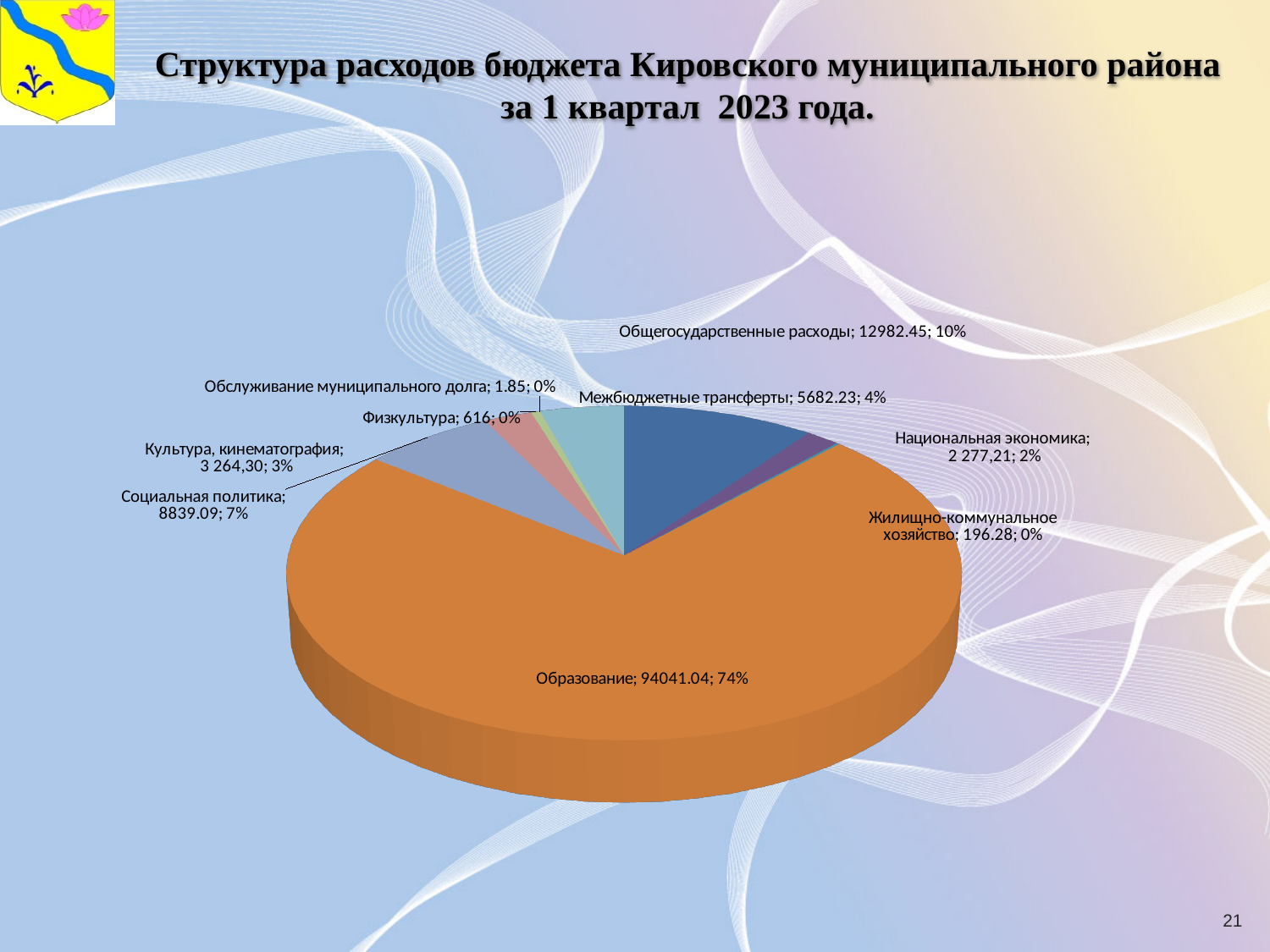
What kind of chart is shown on the slide? Pie chart What share of the pie does Межбюджетные трансферты represent? 4% How many categories (slices) does the pie chart show? 9 What is the difference between the values for Общегосударственные расходы and Межбюджетные трансферты? 7300.22 What share of the pie does Образование represent? 74% Which category has the largest value? Образование Which is larger: the value for Социальная политика or the value for Межбюджетные трансферты? Социальная политика Which category has the smallest value? Обслуживание муниципального долга What is the value for Общегосударственные расходы? 12982.45 What is the value for Образование? 94041.04 What is the value for Жилищно-коммунальное хозяйство? 196.28 What is the value for Социальная политика? 8839.09